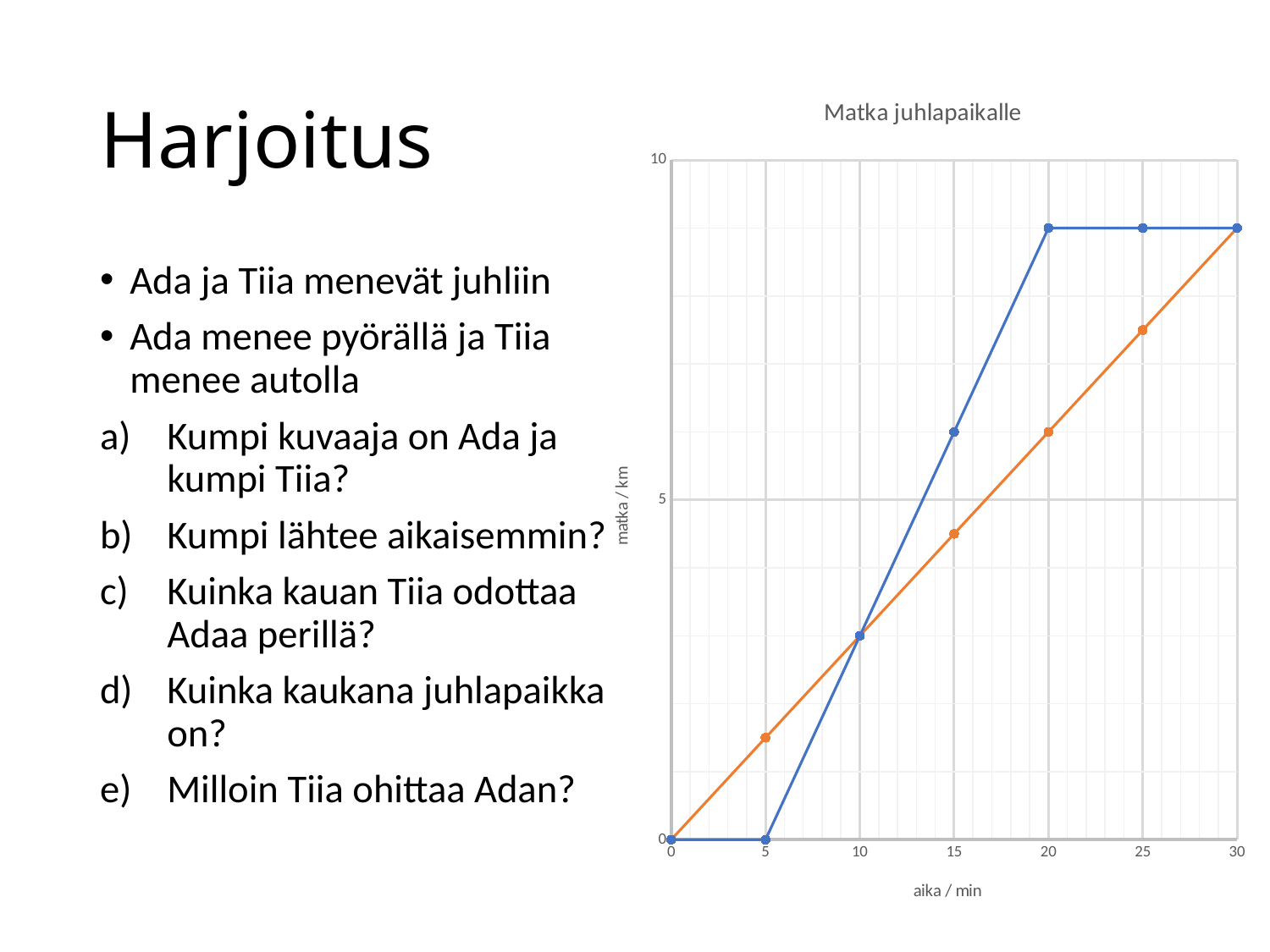
What kind of chart is shown on the slide? line chart At 15 min, which line has the higher value, blue or orange? blue What is the title of the chart? Matka juhlapaikalle Is the value of the blue line at 20 min greater or less than 5? greater Is the value of the blue line at 10 min greater or less than 5? less Is the value of the orange line at 5 min greater or less than 5? less What is the label of the x axis of the chart? aika / min What is the value of the blue line at 5 min? 0 Does the orange line rise or fall as time increases from 0 to 30 min? rise How many lines (series) are plotted on the chart? 2 How many data points does the blue line have? 7 At 5 min, which line has the higher value, blue or orange? orange